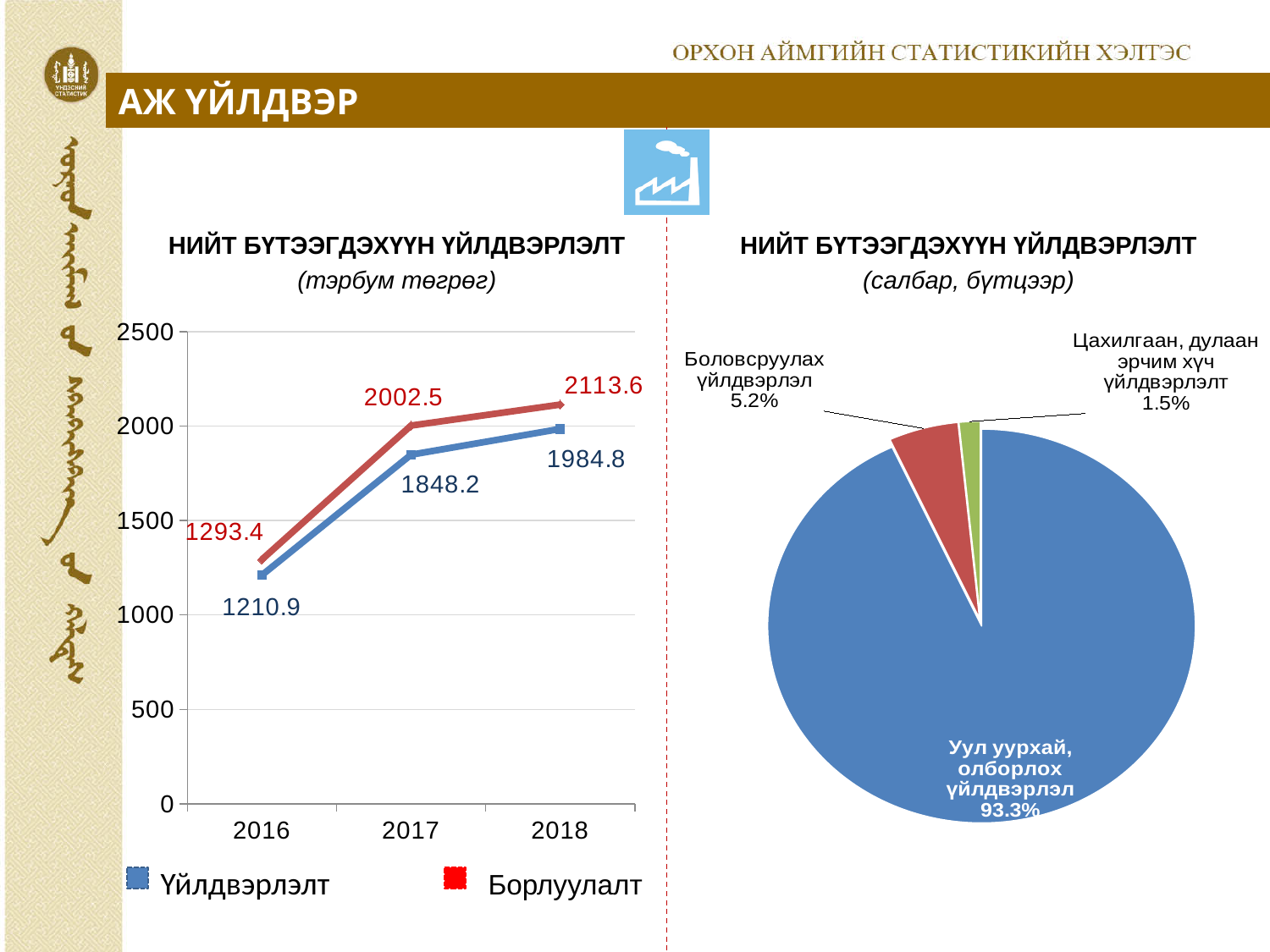
On the left chart (тэрбум төгрөг), which is larger in 2017: Үйлдвэрлэлт or Борлуулалт? Борлуулалт On the right pie chart (салбар, бүтцээр), which sector has the smallest share? Цахилгаан, дулаан эрчим хүч үйлдвэрлэлт On the left chart (тэрбум төгрөг), does Үйлдвэрлэлт rise or fall from 2016 to 2018? rise On the left chart (тэрбум төгрөг), what is the value of Борлуулалт in 2016? 1293.4 On the left chart (тэрбум төгрөг), what is the difference between Борлуулалт and Үйлдвэрлэлт in 2018? 128.8 On the right pie chart (салбар, бүтцээр), what share does Боловсруулах үйлдвэрлэл have? 5.2% On the left chart (тэрбум төгрөг), in which year is Үйлдвэрлэлт highest? 2018 On the left chart (тэрбум төгрөг), what is the value of Үйлдвэрлэлт in 2017? 1848.2 On the left chart (тэрбум төгрөг), what is the value of Борлуулалт in 2018? 2113.6 On the left chart (тэрбум төгрөг), in which year is Борлуулалт lowest? 2016 What kind of chart is the right chart (салбар, бүтцээр)? pie chart How many series does the legend of the left chart (тэрбум төгрөг) list? 2